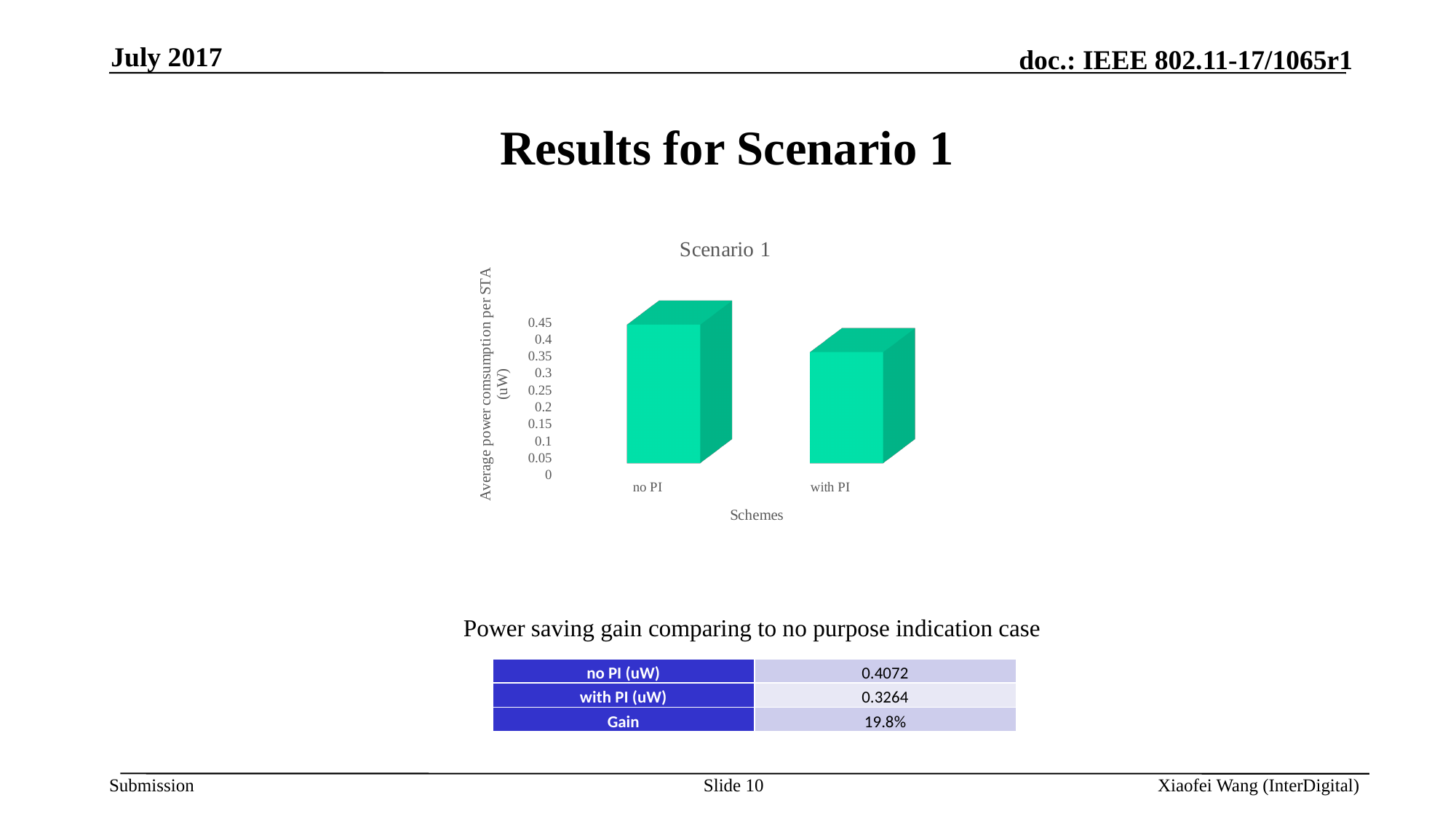
Using the values in the table, what is the difference between the no PI and with PI power consumption? 0.0808 How many schemes (categories) are plotted in the chart? 2 Which scheme has the highest average power consumption per STA? no PI According to the table below the chart, what is the average power consumption for with PI? 0.3264 Is the value for no PI greater or less than 0.35? greater According to the table below the chart, what is the average power consumption for no PI? 0.4072 Which scheme has the lowest average power consumption per STA? with PI Which is larger, the average power consumption for no PI or for with PI? no PI What kind of chart is shown on the slide? bar chart What is the title of the chart? Scenario 1 Is the value for with PI greater or less than 0.4? less What is the label of the x axis of the chart? Schemes